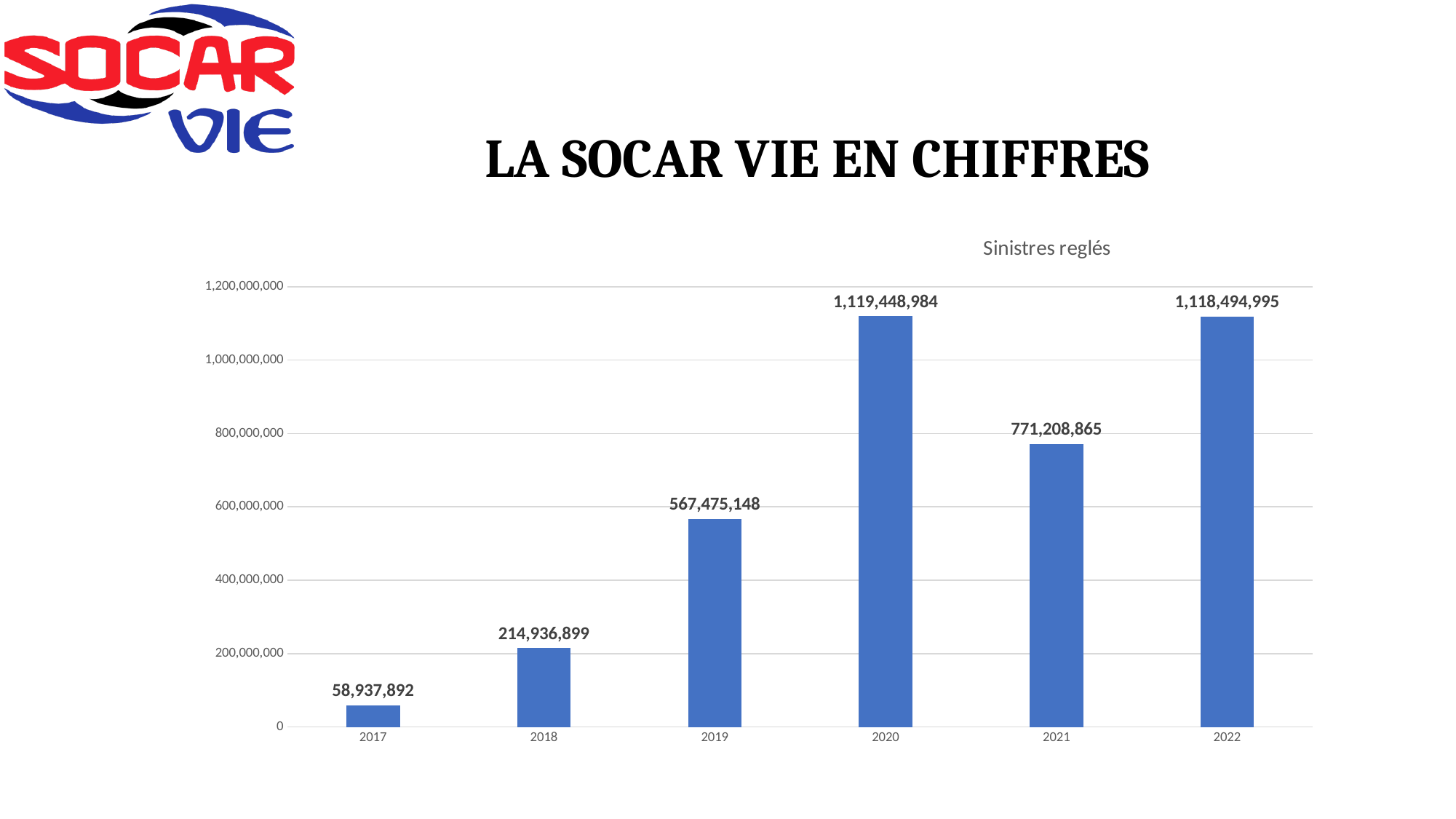
What is the value for 2022? 1,118,494,995 Do the values rise or fall from 2017 to 2020? rise Which year has the highest value? 2020 Which year has the lowest value? 2017 Is the value for 2021 greater or less than 600,000,000? greater What type of chart is shown on the slide? Bar chart What is the difference between the values for 2021 and 2019? 203,733,717 What is the value for 2019? 567,475,148 What is the value for 2021? 771,208,865 How many years are shown on the x axis of the chart? 6 What is the value for 2017? 58,937,892 What is the title of the chart? Sinistres reglés